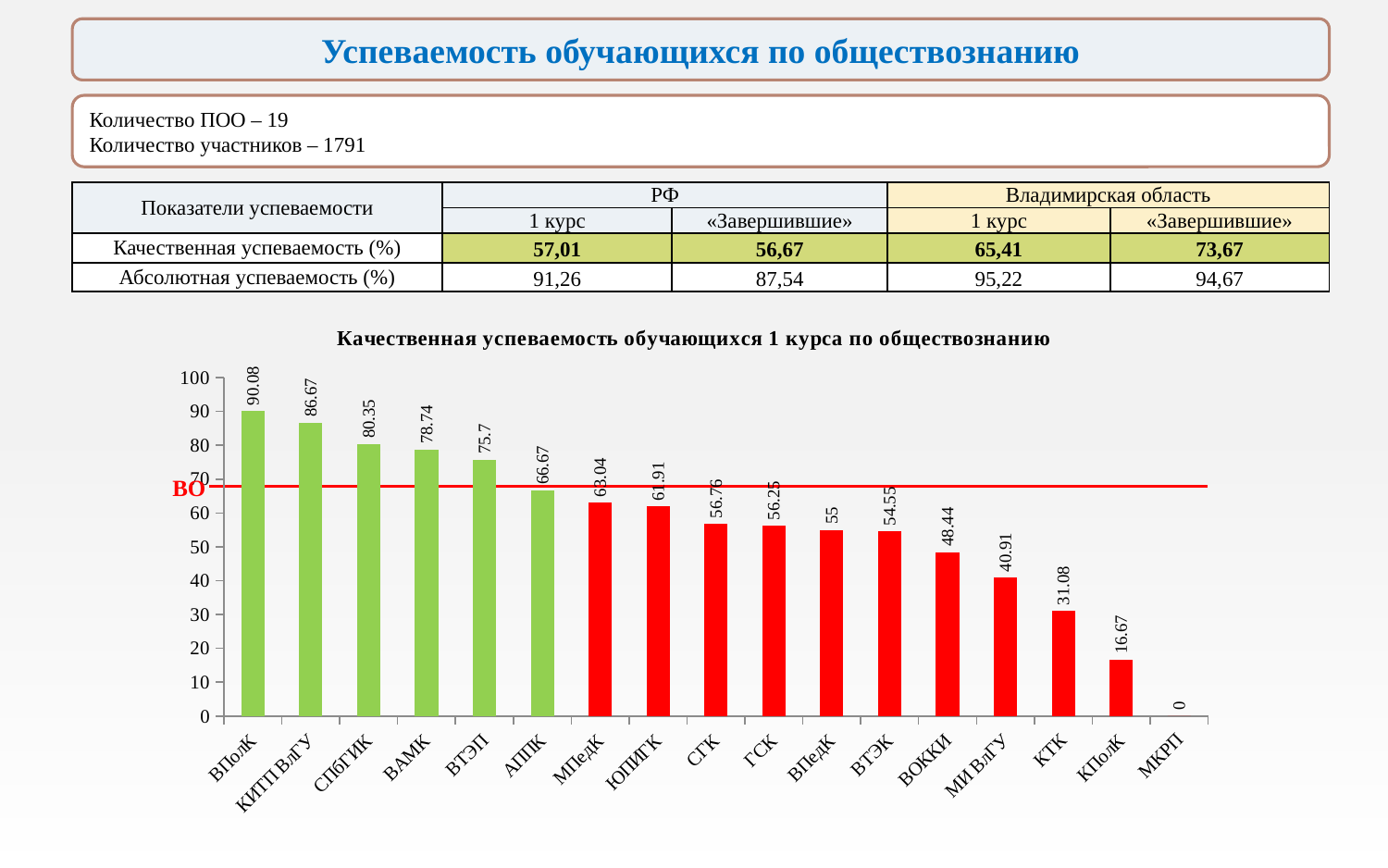
How many categories are shown on the x axis of the chart? 17 What is the title of the chart? Качественная успеваемость обучающихся 1 курса по обществознанию Is the value for МИ ВлГУ greater or less than 50? less What is the value for КТК in the chart? 31.08 What is the value for ВПолК in the chart? 90.08 Which is larger, the value for СПбГИК or the value for ВАМК? СПбГИК What is the difference between the values for ВПолК and КИТП ВлГУ? 3.41 Do the values rise or fall from left to right along the x axis? fall What type of chart is shown on the slide? bar chart Which category has the highest value in the chart? ВПолК What is the value for ВОККИ in the chart? 48.44 Which category has the lowest value in the chart? МКРП